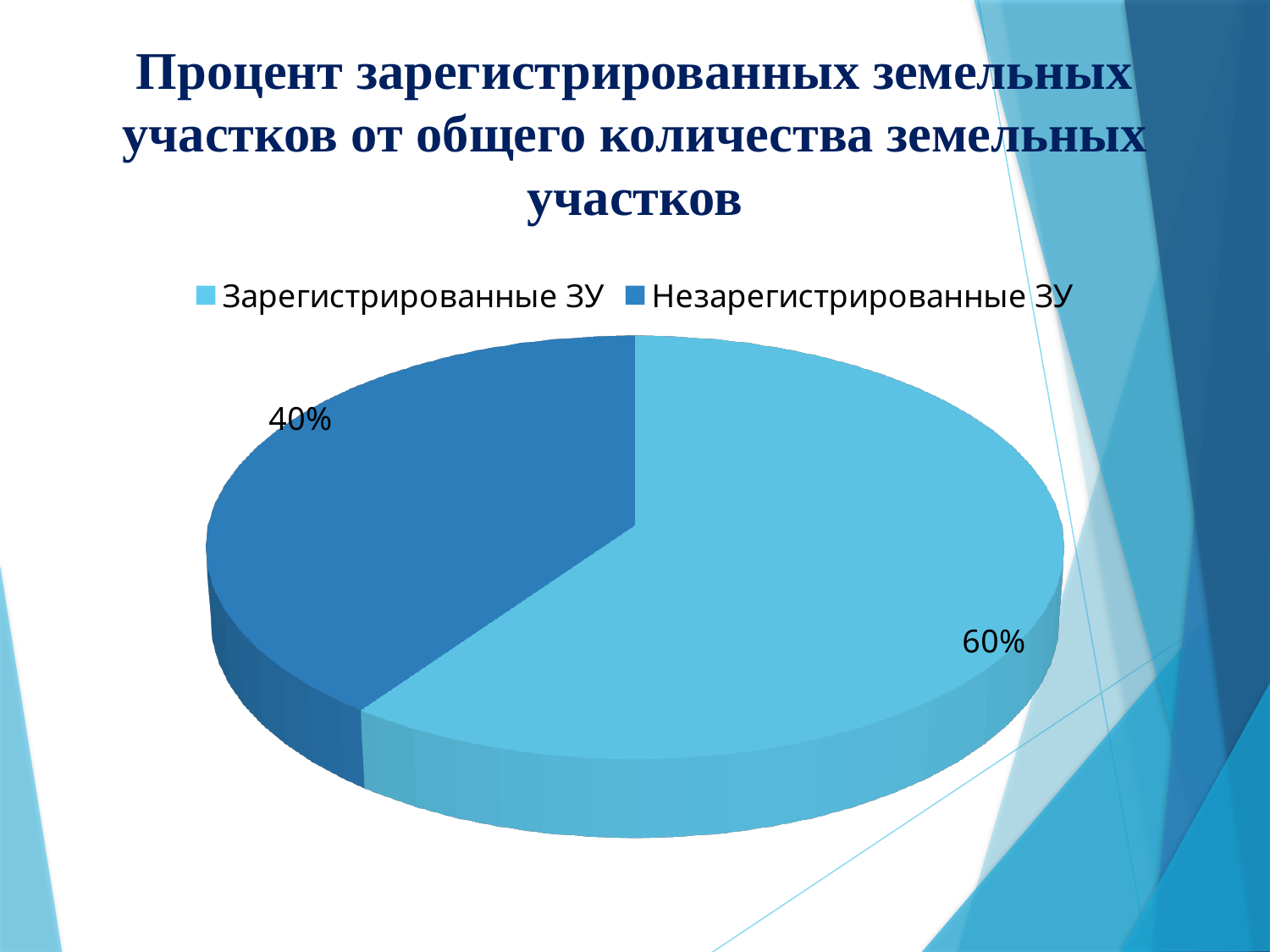
Which legend entry is shown in the darker blue colour? Незарегистрированные ЗУ What percentage is shown for Зарегистрированные ЗУ? 60% Which category has the largest share of the pie? Зарегистрированные ЗУ How many slices does the pie chart have? 2 What is the difference in percentage points between Зарегистрированные ЗУ and Незарегистрированные ЗУ? 20 What share of the pie does the Незарегистрированные ЗУ slice represent? 40% What percentage is shown for Незарегистрированные ЗУ? 40% Which category has the smallest share of the pie? Незарегистрированные ЗУ What is the title of the slide containing the chart? Процент зарегистрированных земельных участков от общего количества земельных участков Which is larger: the share for Зарегистрированные ЗУ or for Незарегистрированные ЗУ? Зарегистрированные ЗУ How many entries does the legend list? 2 What kind of chart is shown on the slide? pie chart